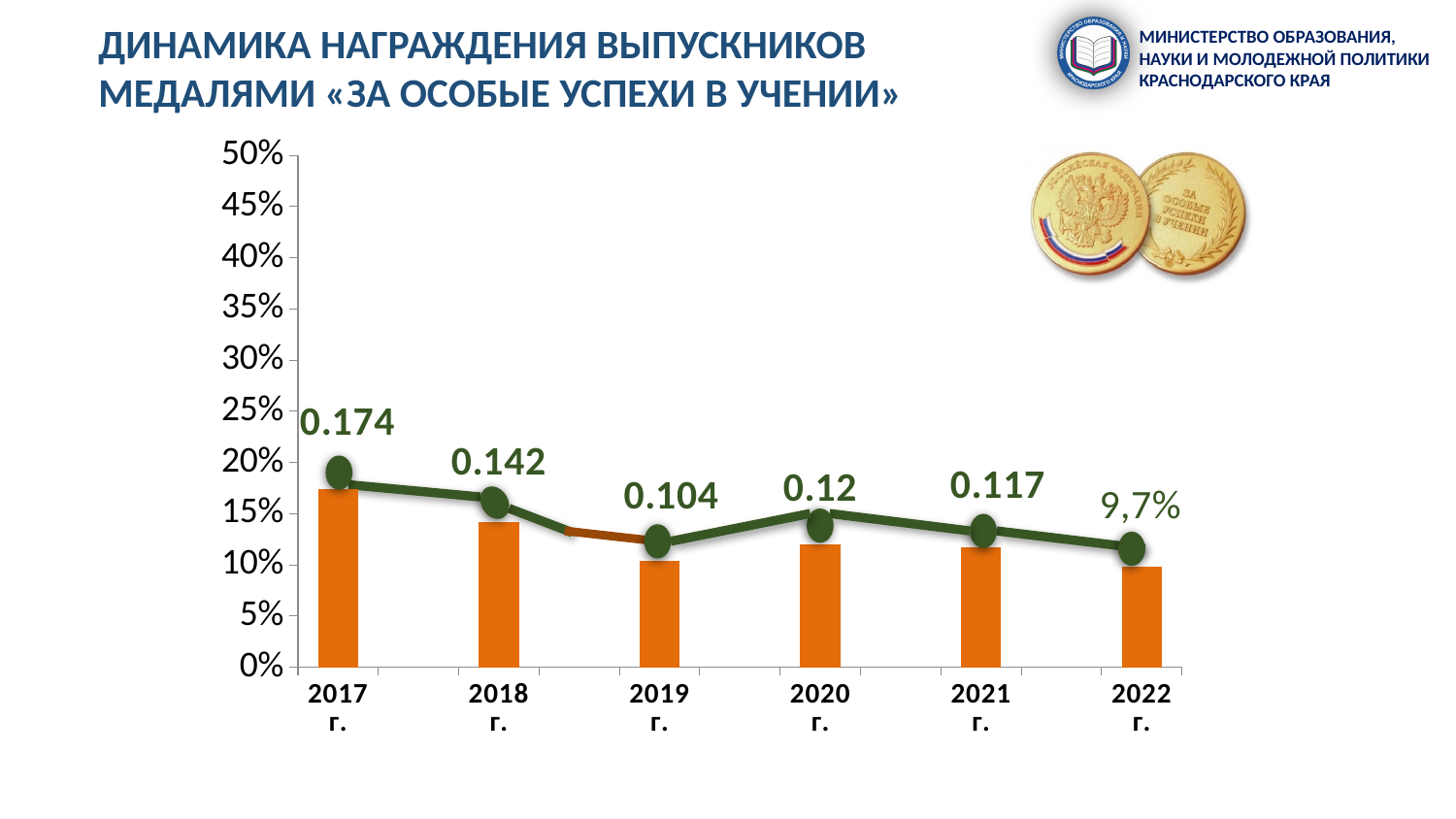
What value is labelled for 2017 г.? 0.174 How many years are shown on the x axis? 6 Which year has the lowest value? 2022 г. Do the values generally rise or fall from 2017 г. to 2022 г.? fall What value is labelled for 2020 г.? 0.12 What kind of chart is shown on the slide? Bar chart with a line overlay What is the difference between the labelled values for 2017 г. and 2018 г.? 0.032 Is the bar for 2017 г. greater or less than 15%? greater What value is labelled for 2019 г.? 0.104 Which is larger, the value for 2018 г. or the value for 2019 г.? 2018 г. What value is labelled for 2022 г.? 9,7% Which year has the highest value? 2017 г.